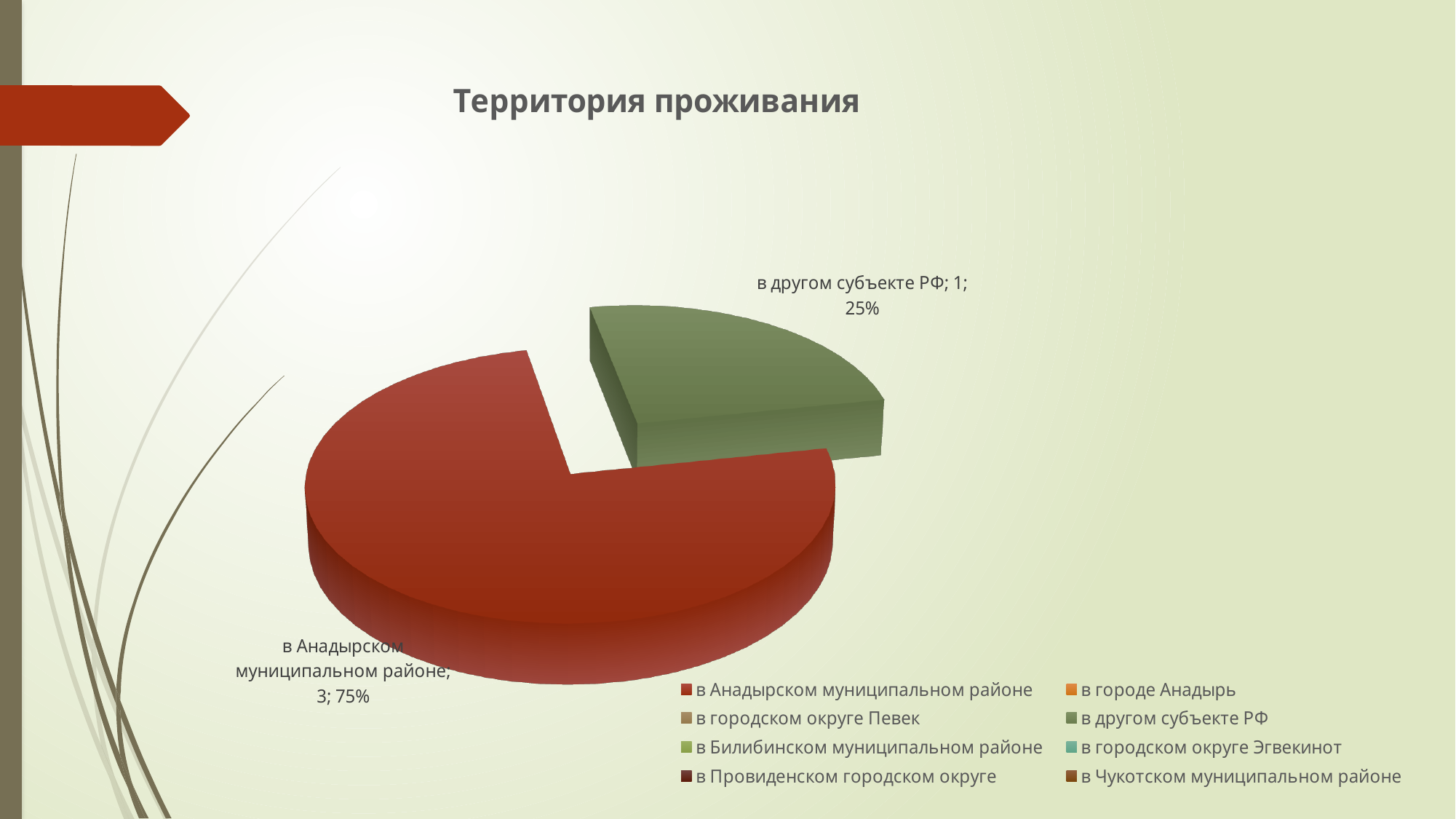
What value is shown for the slice "в другом субъекте РФ"? 1 What share of the pie does "в Анадырском муниципальном районе" represent? 75% What share of the pie does "в другом субъекте РФ" represent? 25% Which is larger: the value for "в Анадырском муниципальном районе" or for "в другом субъекте РФ"? в Анадырском муниципальном районе Which slice is the largest in the pie chart? в Анадырском муниципальном районе Which of the two labelled slices is the smallest? в другом субъекте РФ What is the difference between the values for "в Анадырском муниципальном районе" and "в другом субъекте РФ"? 2 How many slices with data labels are visible in the pie chart? 2 What is the title of the chart? Территория проживания How many entries does the legend list? 8 What kind of chart is shown on the slide? pie chart What value is shown for the slice "в Анадырском муниципальном районе"? 3